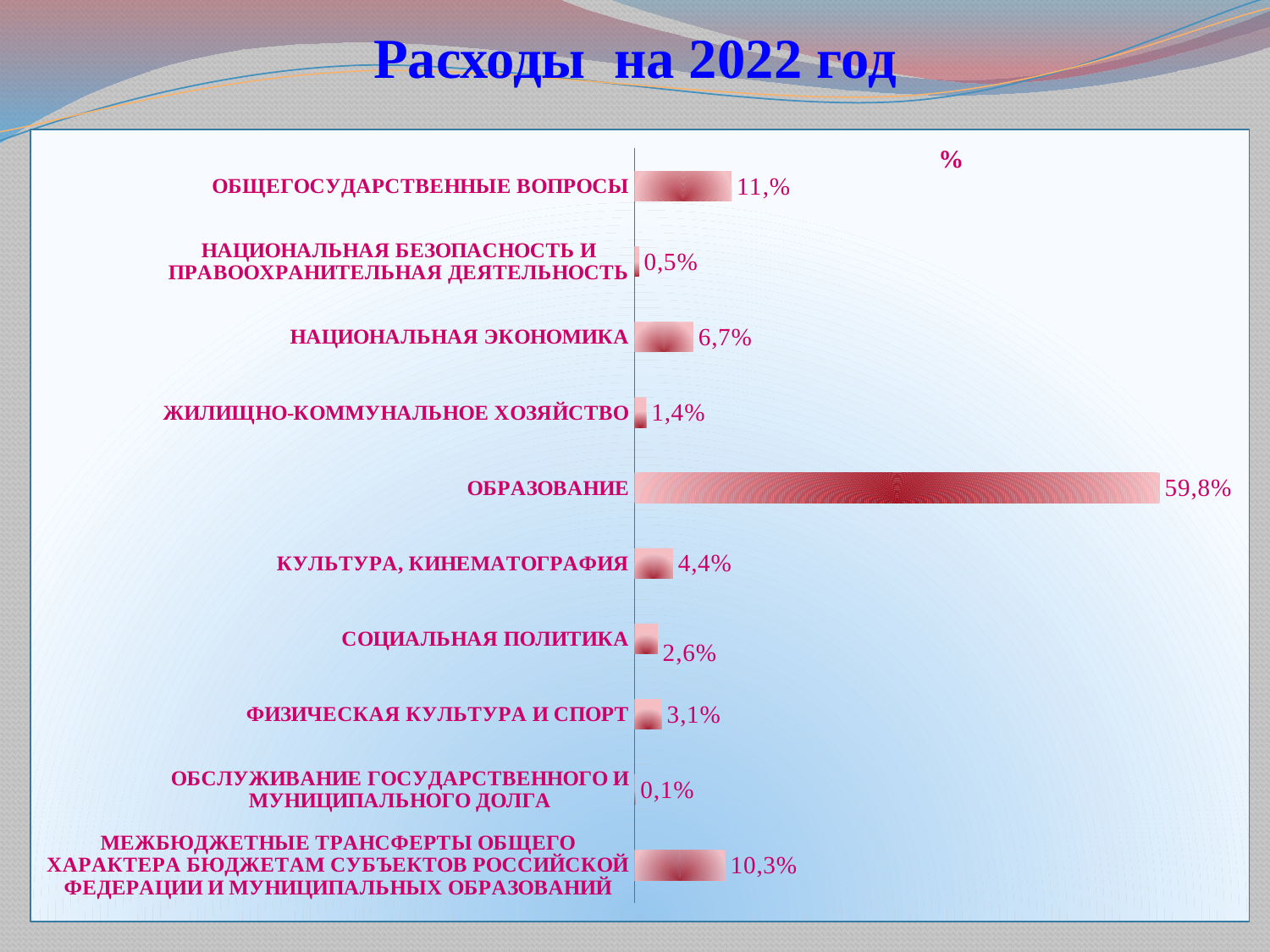
Which is larger, the value for ФИЗИЧЕСКАЯ КУЛЬТУРА И СПОРТ or the value for СОЦИАЛЬНАЯ ПОЛИТИКА? ФИЗИЧЕСКАЯ КУЛЬТУРА И СПОРТ What is the difference between the values for КУЛЬТУРА, КИНЕМАТОГРАФИЯ and ЖИЛИЩНО-КОММУНАЛЬНОЕ ХОЗЯЙСТВО? 3,0% Which category has the lowest value? ОБСЛУЖИВАНИЕ ГОСУДАРСТВЕННОГО И МУНИЦИПАЛЬНОГО ДОЛГА What is the value for ОБСЛУЖИВАНИЕ ГОСУДАРСТВЕННОГО И МУНИЦИПАЛЬНОГО ДОЛГА? 0,1% Which category has the highest value? ОБРАЗОВАНИЕ What is the value for КУЛЬТУРА, КИНЕМАТОГРАФИЯ? 4,4% How many categories are shown in the chart? 10 What is the value for НАЦИОНАЛЬНАЯ ЭКОНОМИКА? 6,7% What is the difference between the values for ОБРАЗОВАНИЕ and НАЦИОНАЛЬНАЯ ЭКОНОМИКА? 53,1% What is the value for ОБРАЗОВАНИЕ? 59,8% What is the title of the slide containing the chart? Расходы на 2022 год What kind of chart is shown on the slide? bar chart